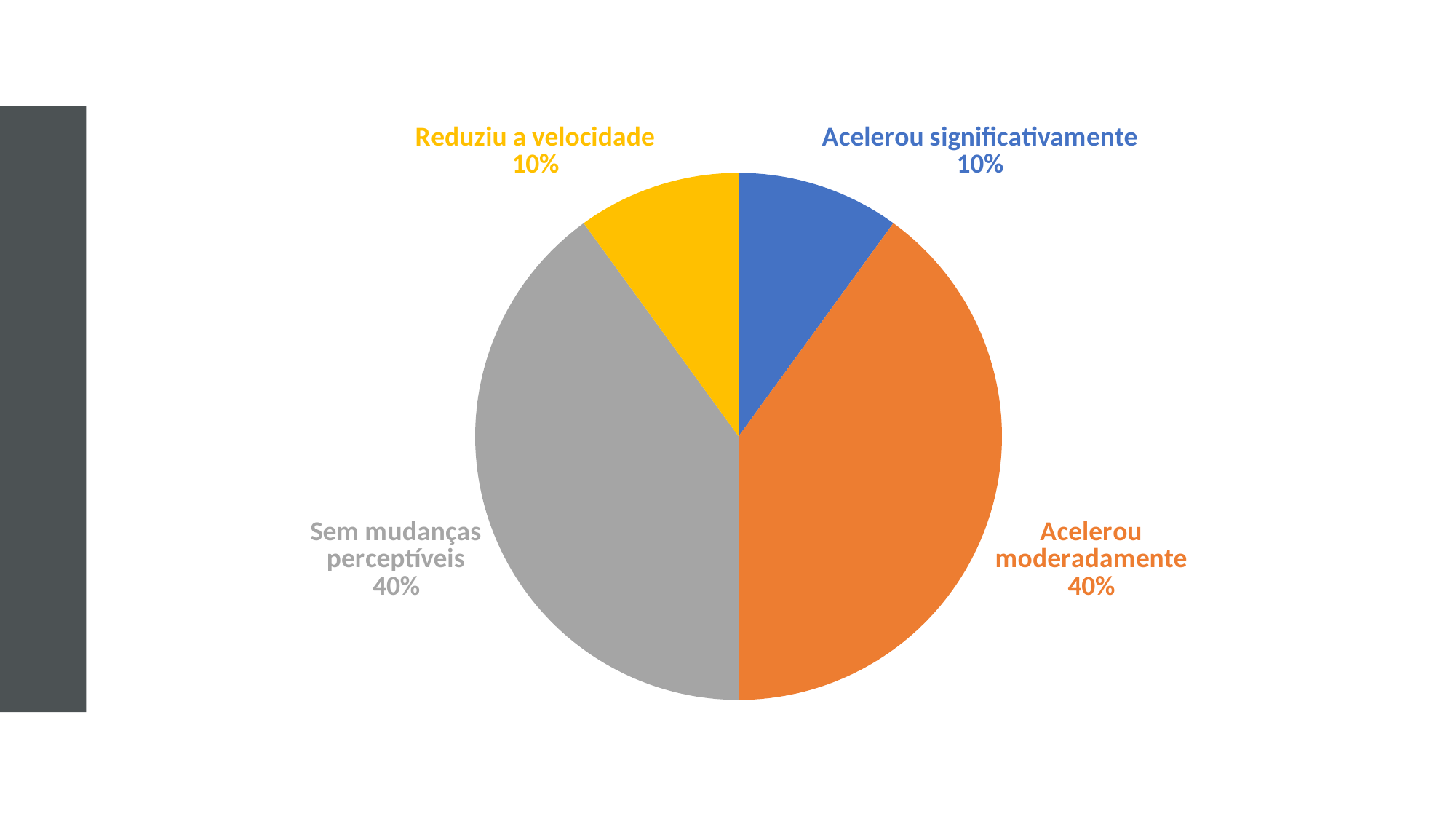
What is the combined share of the "Acelerou significativamente" and "Acelerou moderadamente" slices? 50% Which is larger, the slice for "Acelerou moderadamente" or the slice for "Reduziu a velocidade"? Acelerou moderadamente What share of the pie does "Reduziu a velocidade" represent? 10% What share of the pie does "Acelerou moderadamente" represent? 40% What colour is the "Sem mudanças perceptíveis" slice? grey Which is larger, the slice for "Acelerou significativamente" or the slice for "Sem mudanças perceptíveis"? Sem mudanças perceptíveis What share of the pie does "Acelerou significativamente" represent? 10% What kind of chart is shown on the slide? pie chart What colour is the "Reduziu a velocidade" slice? yellow What is the difference in percentage points between the "Sem mudanças perceptíveis" slice and the "Reduziu a velocidade" slice? 30% How many slices does the pie chart have? 4